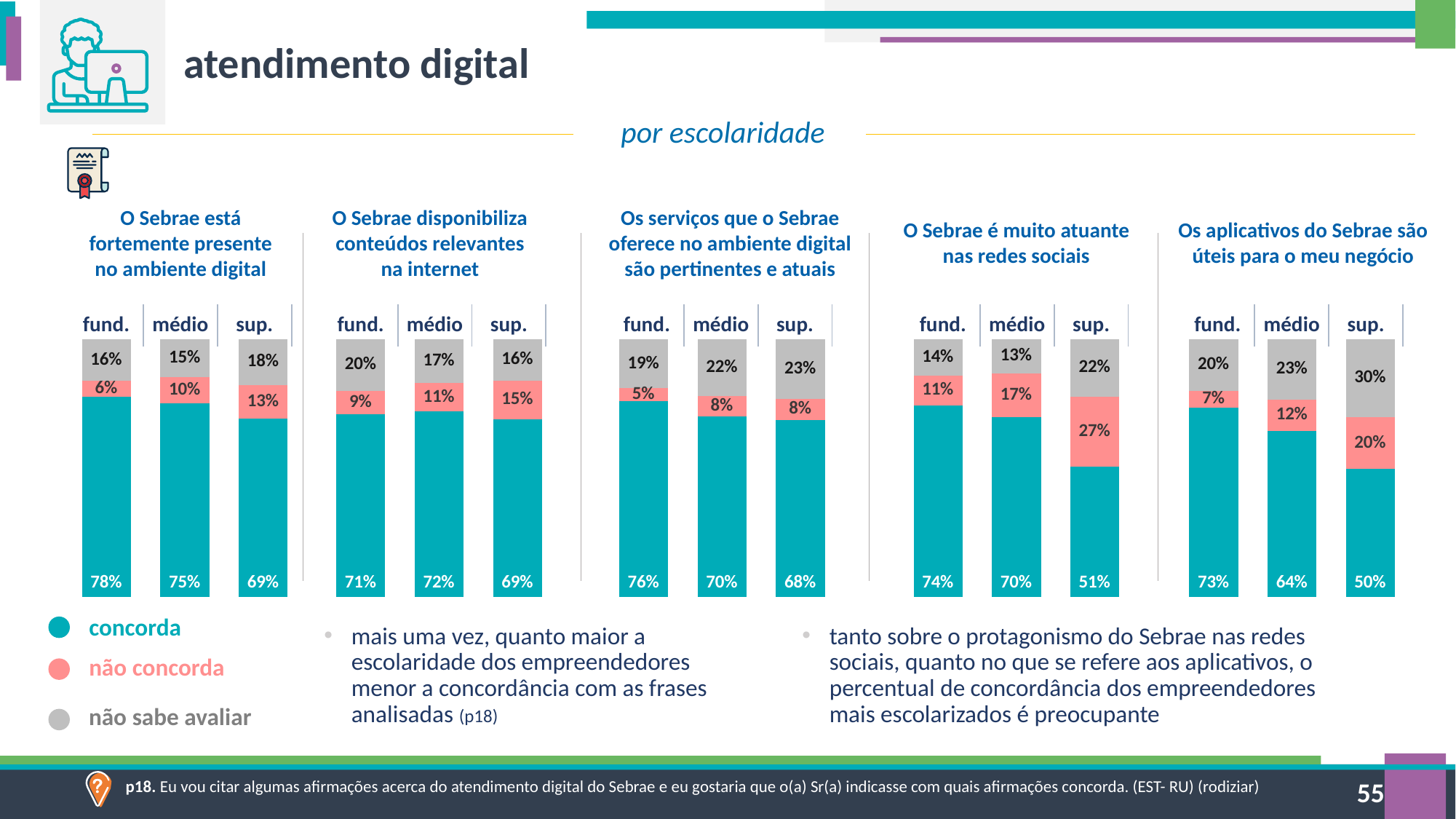
How many education levels are shown in each chart? 3 In the chart 'Os aplicativos do Sebrae são úteis para o meu negócio', which education level has the lowest 'concorda' value? sup. In the chart 'O Sebrae disponibiliza conteúdos relevantes na internet', which education level has the highest 'concorda' value? médio How many series does the legend list? 3 What kind of chart is used on this slide? Stacked bar chart In the chart 'O Sebrae é muito atuante nas redes sociais', what is the total of the sup. stacked bar? 100% In the chart 'O Sebrae é muito atuante nas redes sociais', what is the difference between the 'concorda' values for fund. and sup.? 23 percentage points In the chart 'Os serviços que o Sebrae oferece no ambiente digital são pertinentes e atuais', is the 'não sabe avaliar' value larger for fund. or for sup.? sup. In the chart 'Os aplicativos do Sebrae são úteis para o meu negócio', does the 'concorda' value rise or fall from fund. to sup.? Fall In the chart 'O Sebrae é muito atuante nas redes sociais', what is the 'não concorda' value for sup.? 27% In the chart 'O Sebrae está fortemente presente no ambiente digital', what is the 'concorda' value for fund.? 78% In the chart 'Os aplicativos do Sebrae são úteis para o meu negócio', what is the 'não sabe avaliar' value for sup.? 30%